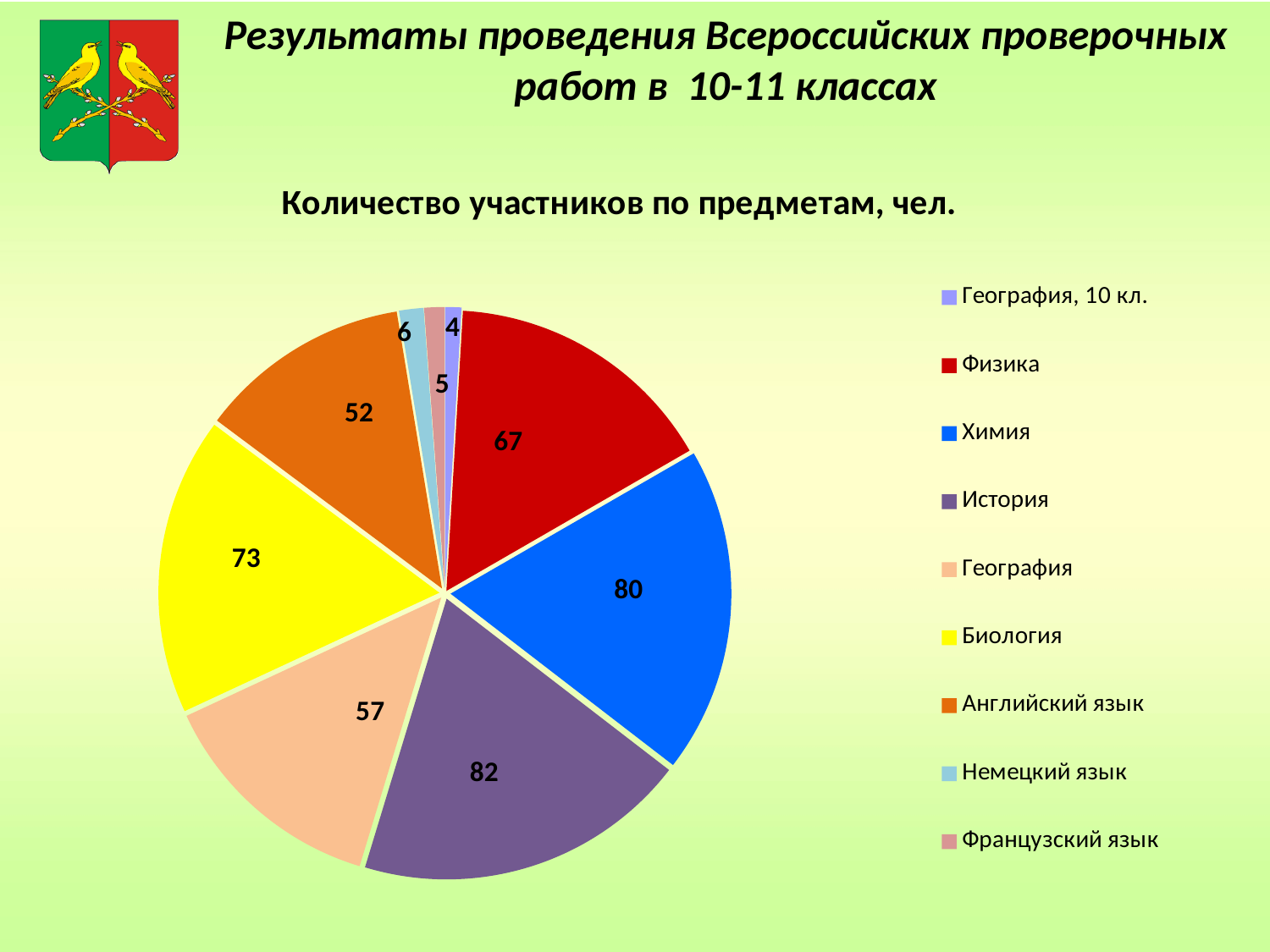
How many participants took the Физика test? 67 How many subjects (slices) does the pie chart show? 9 Which has more participants, География or Физика? Физика What type of chart is shown on the slide? pie chart How many participants took the Биология test? 73 How many participants took the Немецкий язык test? 6 Which subject has the smallest number of participants? География, 10 кл. What is the total number of participants across all subjects in the chart? 426 What is the title of the chart? Количество участников по предметам, чел. How many participants took the Химия test? 80 What is the difference between the number of participants in История and in Английский язык? 30 Which subject has the largest number of participants? История